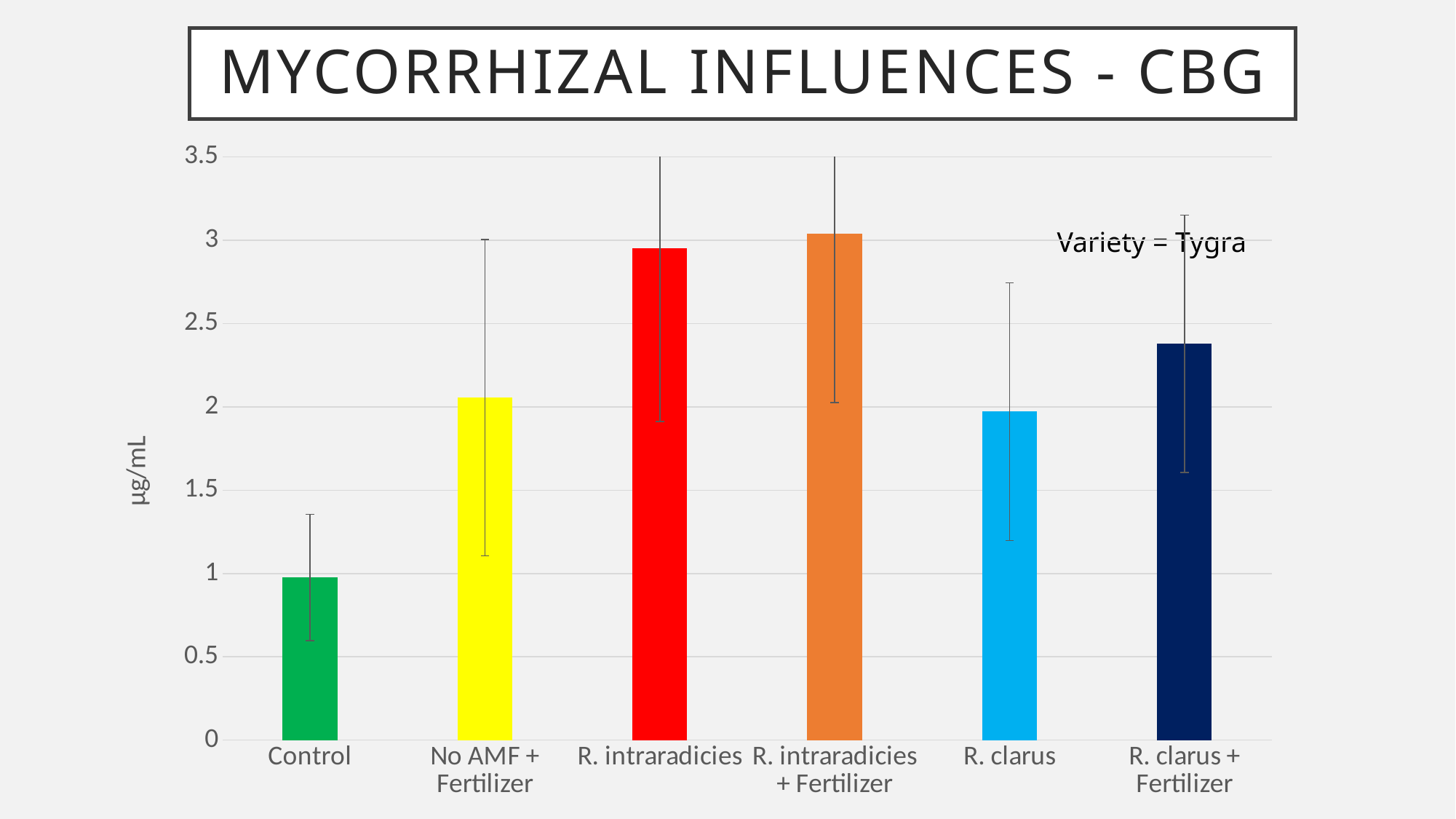
Is the value for R. clarus greater or less than 1.5? greater How many categories are plotted on the x axis? 6 Is the value for Control greater or less than 0.5? greater Which is larger, the value for R. intraradicies or the value for R. clarus? R. intraradicies Is the value for No AMF + Fertilizer greater or less than 2.5? less Which category has the lowest value? Control Which is larger, the value for Control or the value for No AMF + Fertilizer? No AMF + Fertilizer What unit is shown on the y axis label? µg/mL Which category has the highest value? R. intraradicies + Fertilizer What kind of chart is shown on the slide? bar chart